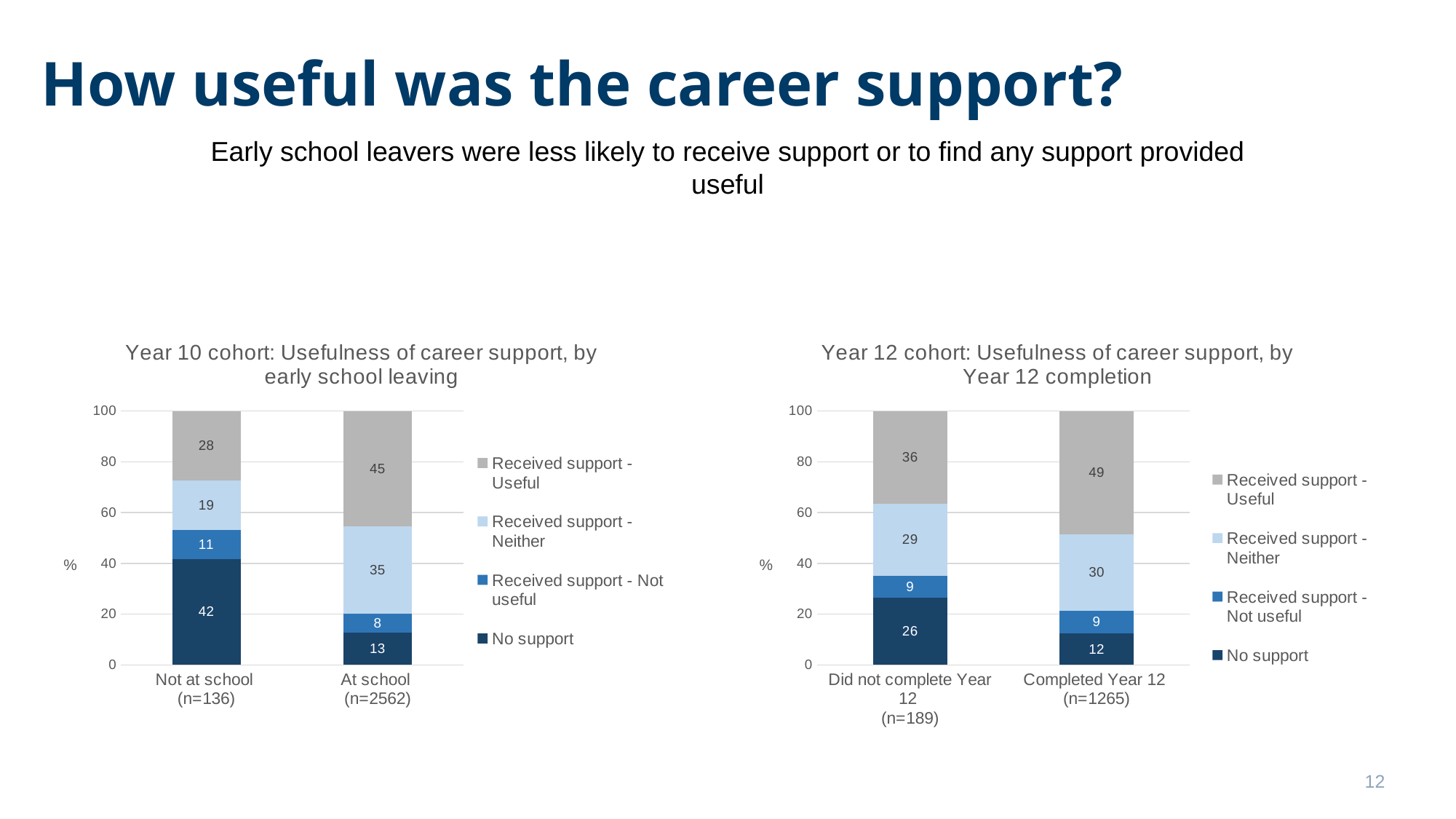
How many series does the legend of the Year 12 cohort chart list? 4 In the Year 12 cohort chart, what is the value for Received support - Neither for Did not complete Year 12 (n=189)? 29 In the Year 12 cohort chart, what is the value for No support for Completed Year 12 (n=1265)? 12 What kind of chart is the Year 10 cohort chart? Stacked bar chart In the Year 10 cohort chart, which category has the higher Received support - Neither value? At school In the Year 10 cohort chart, what is the value for Received support - Useful for At school (n=2562)? 45 In the Year 10 cohort chart, what is the difference between the No support values for Not at school and At school? 29 In the Year 10 cohort chart, what is the value for No support for Not at school (n=136)? 42 In the Year 12 cohort chart, which category has the larger Received support - Useful value, Did not complete Year 12 or Completed Year 12? Completed Year 12 In the Year 12 cohort chart, which colour represents No support? Dark blue In the Year 12 cohort chart, what is the total of the stacked bar for Did not complete Year 12 (n=189)? 100 How many categories are shown on the x axis of the Year 10 cohort chart? 2